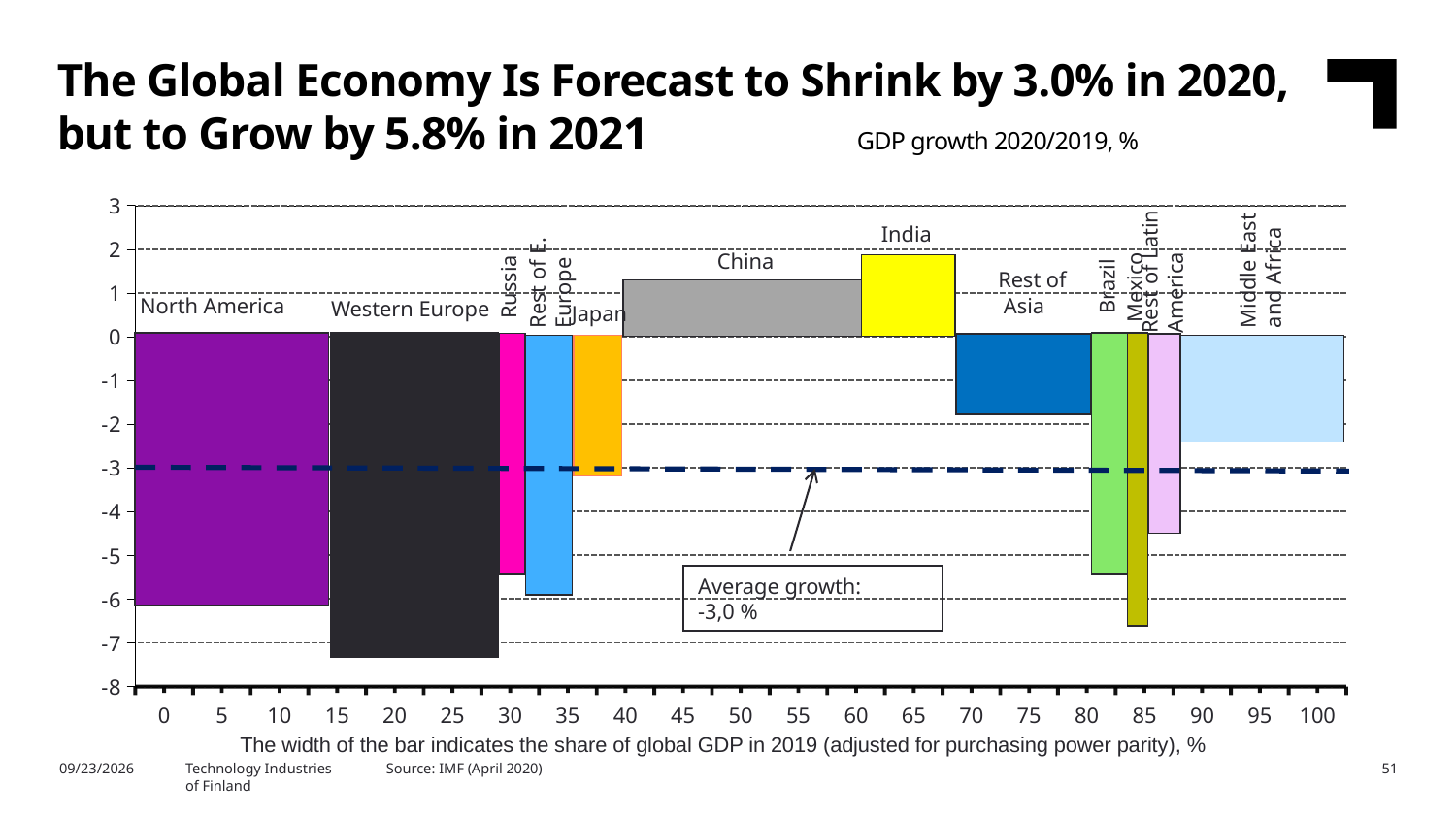
What average growth value is printed in the annotation box on the chart? -3,0 % Which country or region has the lowest GDP growth in the chart? Western Europe Is the GDP growth value for Brazil greater or less than -4? less Which country or region has the highest GDP growth in the chart? India Is the GDP growth value for Middle East and Africa greater or less than -3? greater How many countries or regions are shown as bars in the chart? 12 What kind of chart is shown on the slide? bar chart Is the GDP growth value for North America greater or less than -5? less Which has the higher GDP growth, China or India? India According to the note below the x axis, what does the width of each bar indicate? The share of global GDP in 2019 (adjusted for purchasing power parity), %